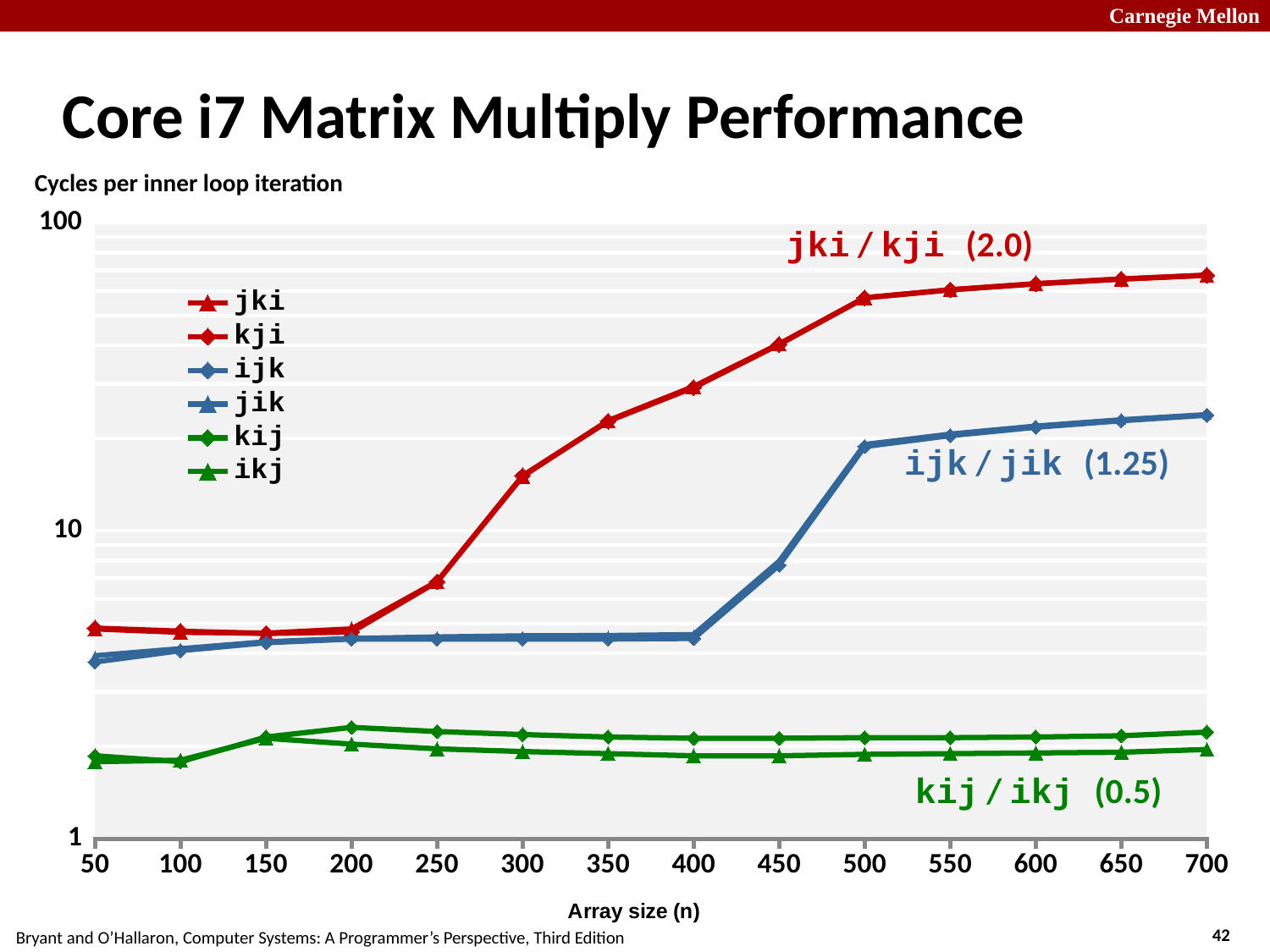
Which is larger at array size 700: the value for jki or the value for kij? jki How many series does the legend list? 6 How many array size values are marked along the x axis? 14 What kind of chart is shown on the slide? line chart Is the value for ijk at array size 500 greater or less than 10? greater Do the values for jki rise or fall as array size increases from 200 to 700? rise Is the value for ijk at array size 400 greater or less than 10? less Is the value for kij at array size 700 greater or less than 10? less What is the label of the x axis? Array size (n) What is the title of the chart? Core i7 Matrix Multiply Performance